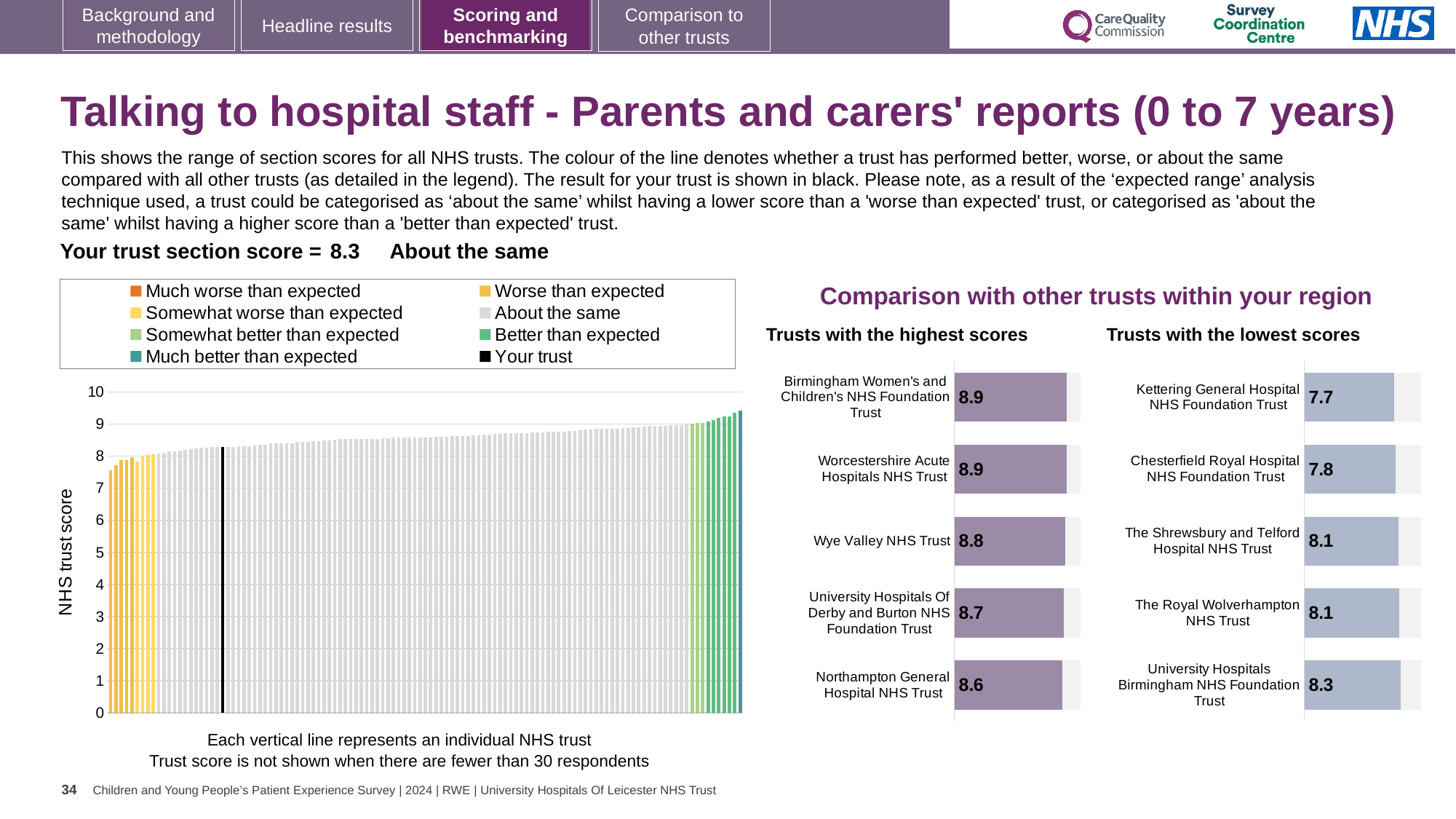
In the NHS trust score chart on the left, is the value of the leftmost bar greater or less than 8? less In the 'Trusts with the highest scores' chart, which trust has the lowest score shown? Northampton General Hospital NHS Trust In the 'Trusts with the lowest scores' chart, what is the score for Kettering General Hospital NHS Foundation Trust? 7.7 In the NHS trust score chart on the left, do the values rise or fall from left to right? Rise What kind of chart is the NHS trust score chart on the left of the slide? Bar chart In the 'Trusts with the lowest scores' chart, which has the higher score: Chesterfield Royal Hospital NHS Foundation Trust or The Royal Wolverhampton NHS Trust? The Royal Wolverhampton NHS Trust How many entries does the legend of the NHS trust score chart on the left list? 8 In the 'Trusts with the highest scores' chart, what is the difference between the scores of Birmingham Women's and Children's NHS Foundation Trust and Northampton General Hospital NHS Trust? 0.3 How many trusts are listed in the 'Trusts with the highest scores' chart? 5 In the 'Trusts with the lowest scores' chart, which trust has the lowest score? Kettering General Hospital NHS Foundation Trust In the 'Trusts with the highest scores' chart, what is the score for Wye Valley NHS Trust? 8.8 In the 'Trusts with the lowest scores' chart, what is the difference between the scores of University Hospitals Birmingham NHS Foundation Trust and Kettering General Hospital NHS Foundation Trust? 0.6